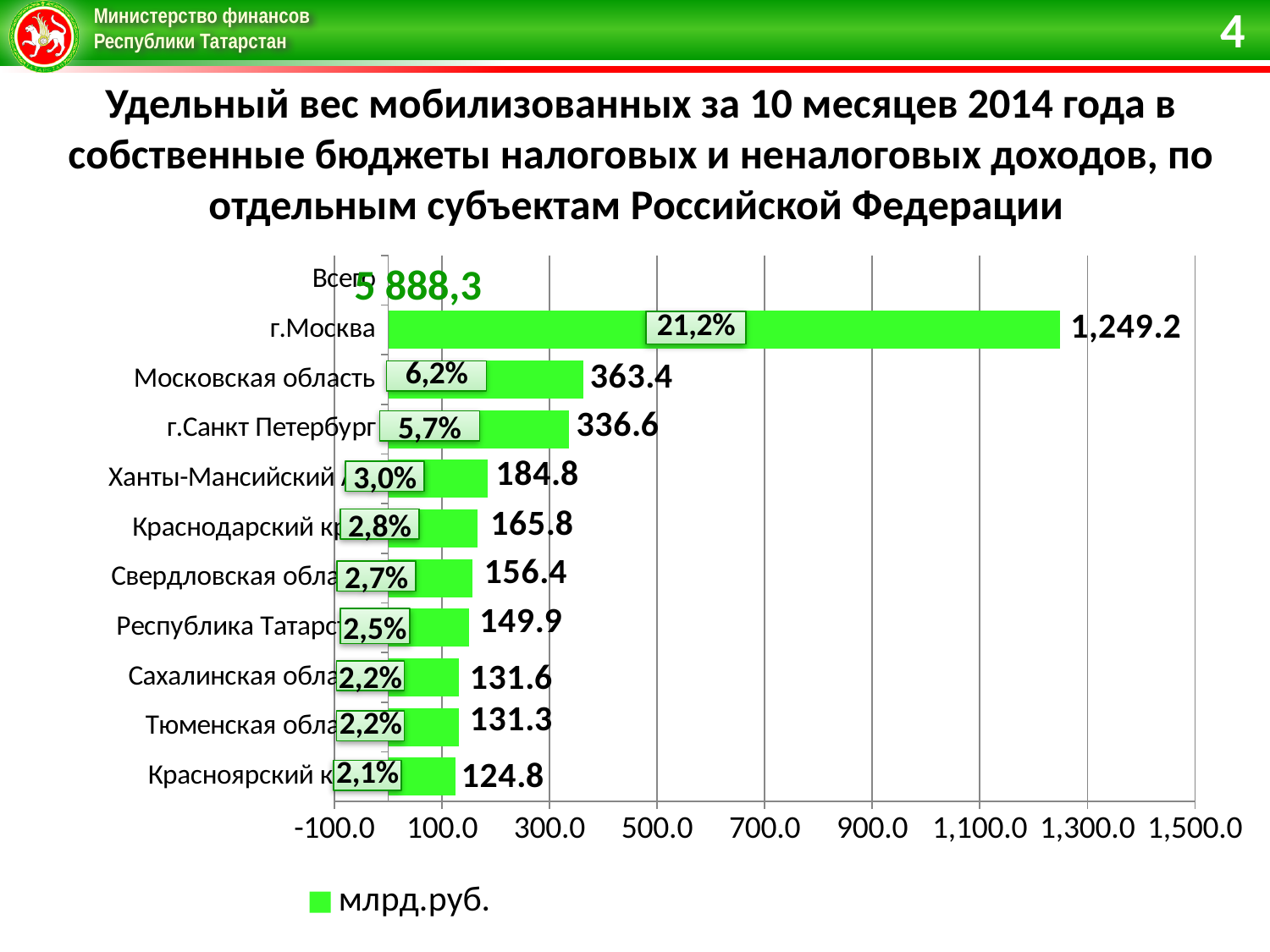
Which region has the lowest value? Красноярский край Which is larger, the value for Ханты-Мансийский or the value for Краснодарский край? Ханты-Мансийский What is the legend entry of the chart? млрд.руб. What is the value for Московская область? 363.4 What percentage share is shown on the bar for г.Москва? 21,2% What type of chart is shown on the slide? bar chart What is the difference between the values for Московская область and г.Санкт Петербург? 26.8 What percentage share is shown on the bar for Республика Татарстан? 2,5% What is the value for г.Санкт Петербург? 336.6 How many bars are plotted in the chart? 10 What is the value for г.Москва? 1,249.2 Which region has the highest value? г.Москва